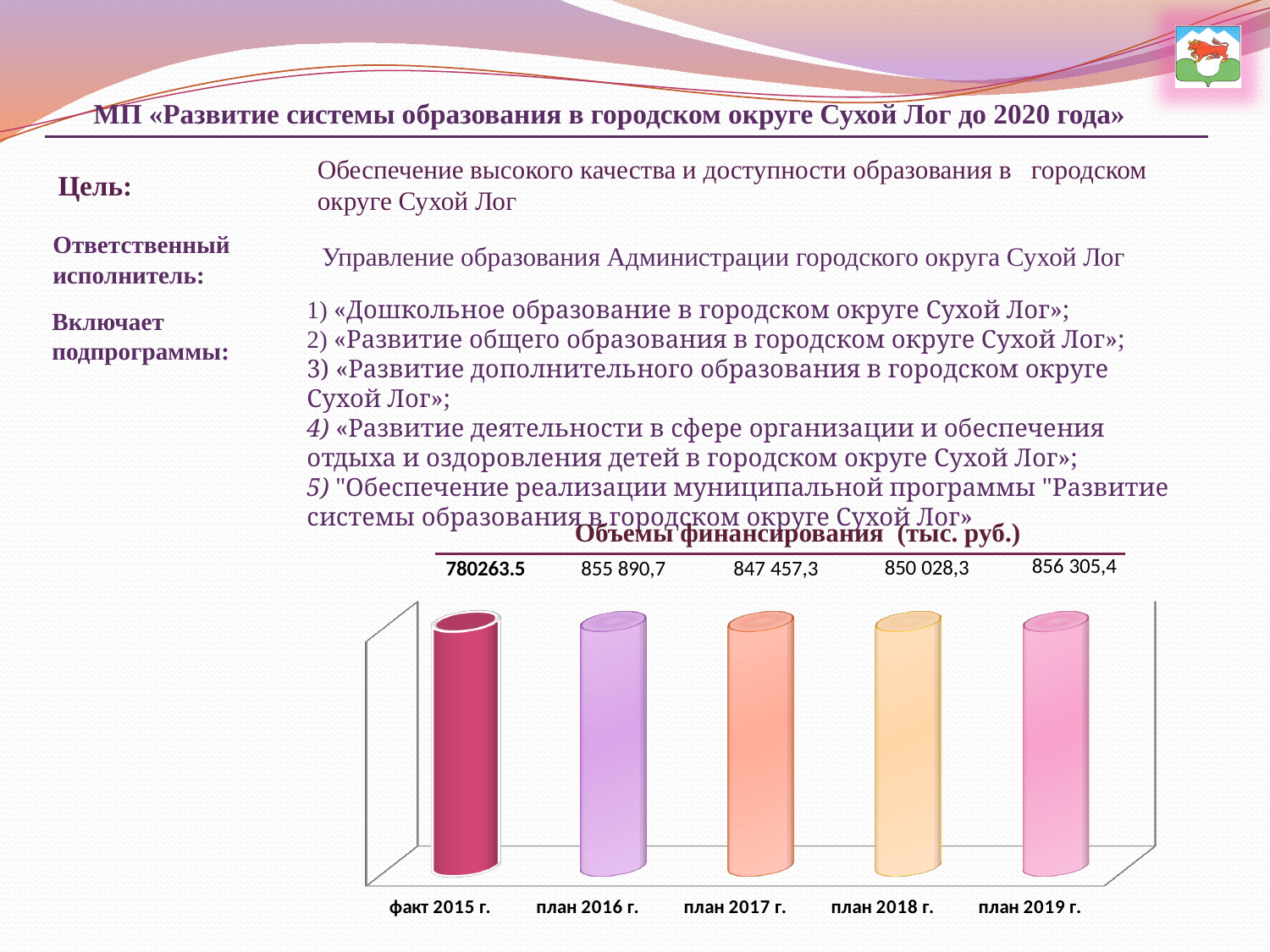
What is the value for факт 2015 г. in the chart Объемы финансирования (тыс. руб.)? 780263.5 What is the value for план 2016 г. in the chart Объемы финансирования (тыс. руб.)? 855 890,7 What is the value for план 2018 г. in the chart Объемы финансирования (тыс. руб.)? 850 028,3 In the chart Объемы финансирования (тыс. руб.), what is the difference between план 2019 г. and план 2018 г.? 6 277,1 Which category has the lowest value in the chart Объемы финансирования (тыс. руб.)? факт 2015 г. Which category has the highest value in the chart Объемы финансирования (тыс. руб.)? план 2019 г. How many categories are shown in the chart Объемы финансирования (тыс. руб.)? 5 What is the value for план 2017 г. in the chart Объемы финансирования (тыс. руб.)? 847 457,3 What kind of chart is Объемы финансирования (тыс. руб.)? bar chart In the chart Объемы финансирования (тыс. руб.), which is larger: план 2016 г. or план 2017 г.? план 2016 г. What is the value for план 2019 г. in the chart Объемы финансирования (тыс. руб.)? 856 305,4 In the chart Объемы финансирования (тыс. руб.), what is the difference between план 2018 г. and план 2017 г.? 2 571,0